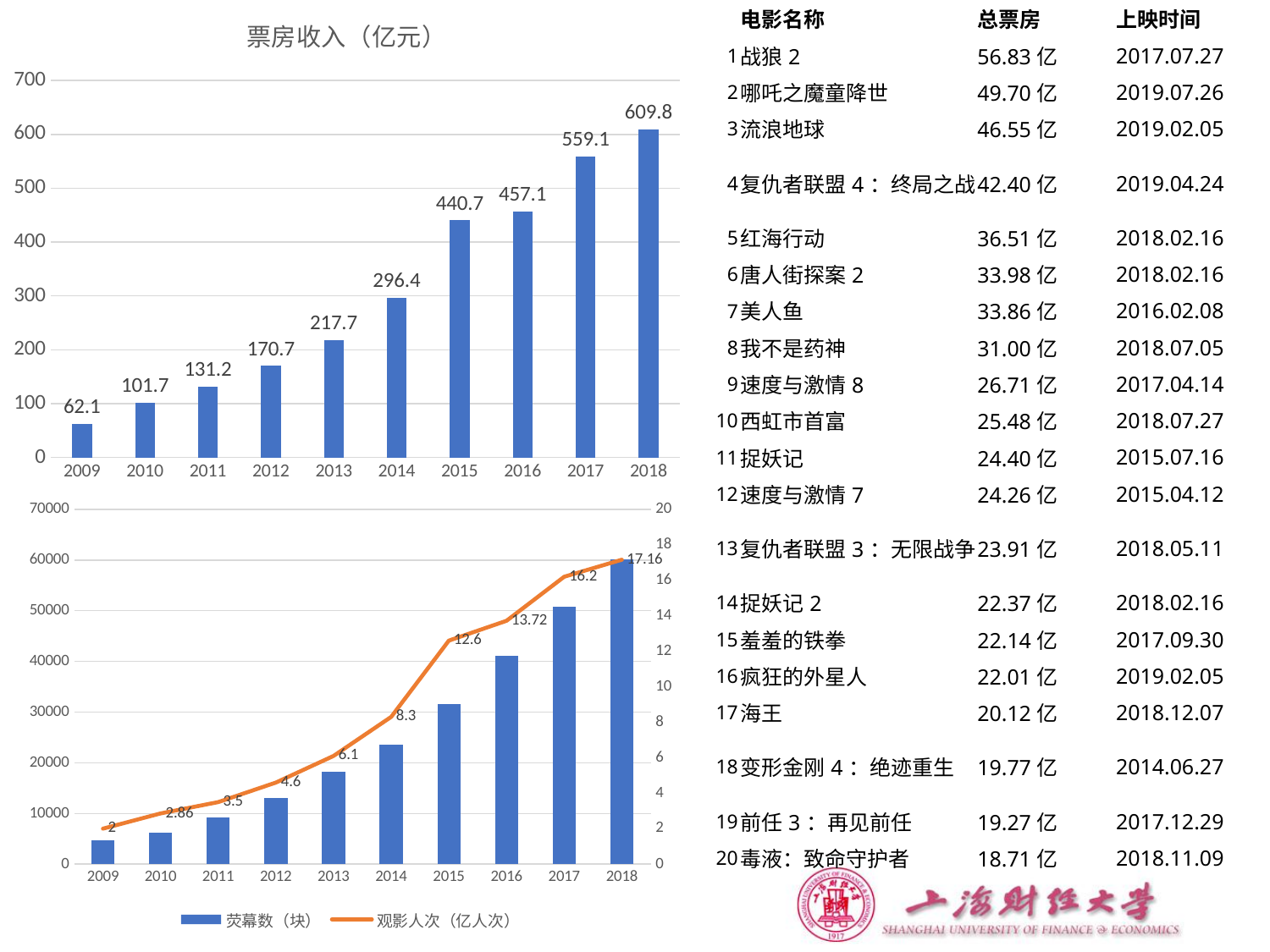
In the bottom chart, which is larger for 荧幕数（块）: 2016 or 2014? 2016 In the bottom chart, is the 荧幕数（块） bar for 2018 greater or less than 50000? greater What kind of chart is the top chart titled 票房收入（亿元）? bar chart In the top chart titled 票房收入（亿元）, how many years are plotted? 10 In the top chart titled 票房收入（亿元）, do the values rise or fall from 2009 to 2018? rise In the bottom chart, what is the value of the 观影人次（亿人次） line for 2015? 12.6 In the bottom chart, how many series does the legend list? 2 In the top chart titled 票房收入（亿元）, what is the difference between the 2017 and 2016 values? 102.0 In the top chart titled 票房收入（亿元）, what is the value for 2013? 217.7 In the top chart titled 票房收入（亿元）, what is the value for 2018? 609.8 In the bottom chart, what is the value of the 观影人次（亿人次） line for 2018? 17.16 In the top chart titled 票房收入（亿元）, which year has the lowest value? 2009